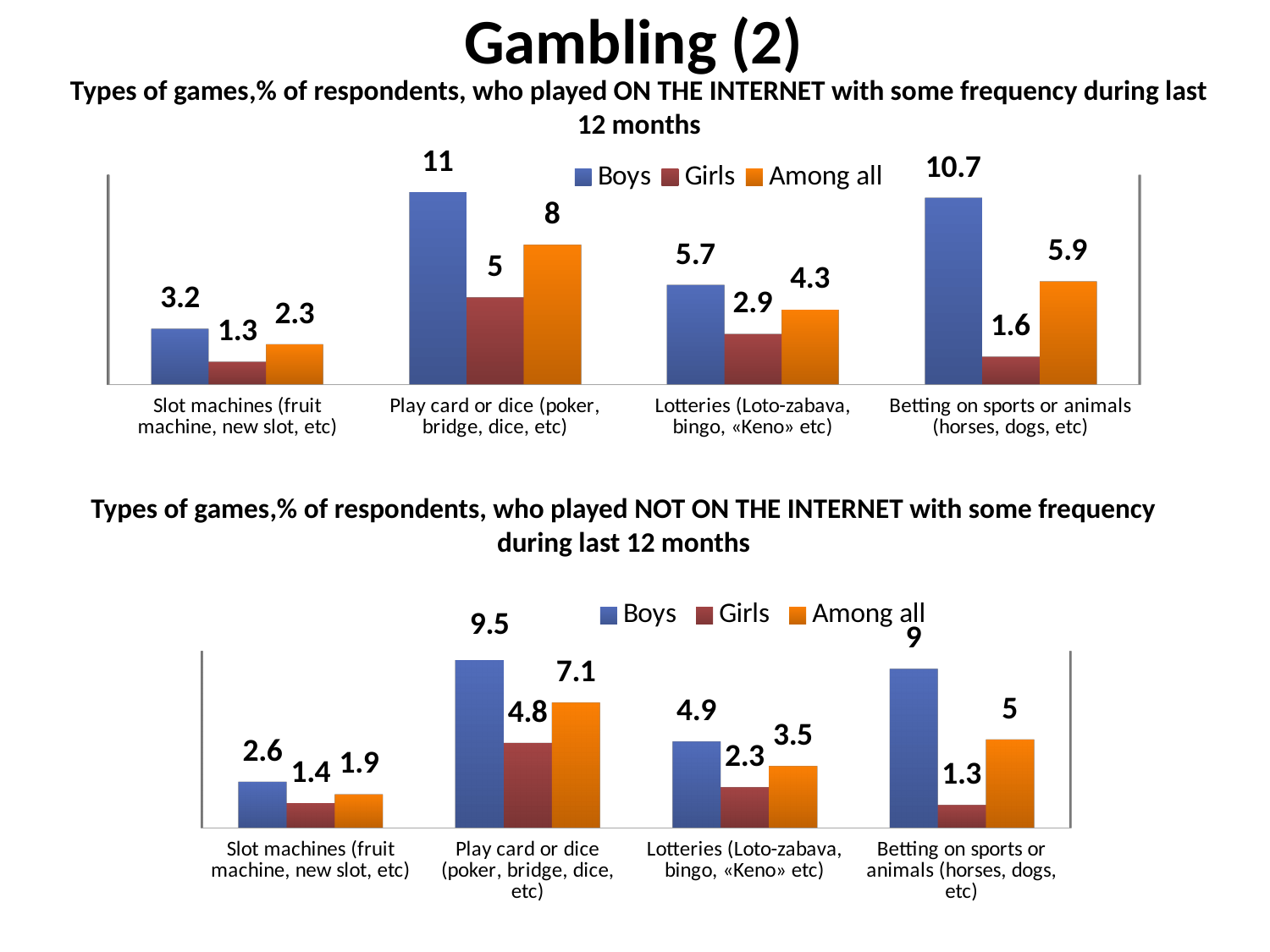
In the bottom chart (played NOT ON THE INTERNET), which is larger for Slot machines: the Girls value or the Among all value? Among all In the bottom chart (played NOT ON THE INTERNET), which category has the highest value for Boys? Play card or dice (poker, bridge, dice, etc) How many categories are shown on the x axis of the top chart (played ON THE INTERNET)? 4 In the top chart (played ON THE INTERNET), what is the difference between the Boys and Girls values for Betting on sports or animals? 9.1 What kind of chart is the top chart (played ON THE INTERNET)? Bar chart How many series does the legend of the bottom chart (played NOT ON THE INTERNET) list? 3 In the bottom chart (played NOT ON THE INTERNET), what is the value for Among all for Lotteries? 3.5 In the top chart (played ON THE INTERNET), what is the value for Boys for Play card or dice? 11 In the top chart (played ON THE INTERNET), which series is shown in orange? Among all In the top chart (played ON THE INTERNET), what is the value for Girls for Betting on sports or animals? 1.6 In the top chart (played ON THE INTERNET), which category has the lowest value for Girls? Slot machines (fruit machine, new slot, etc) In the bottom chart (played NOT ON THE INTERNET), what is the difference between the Boys and Among all values for Play card or dice? 2.4